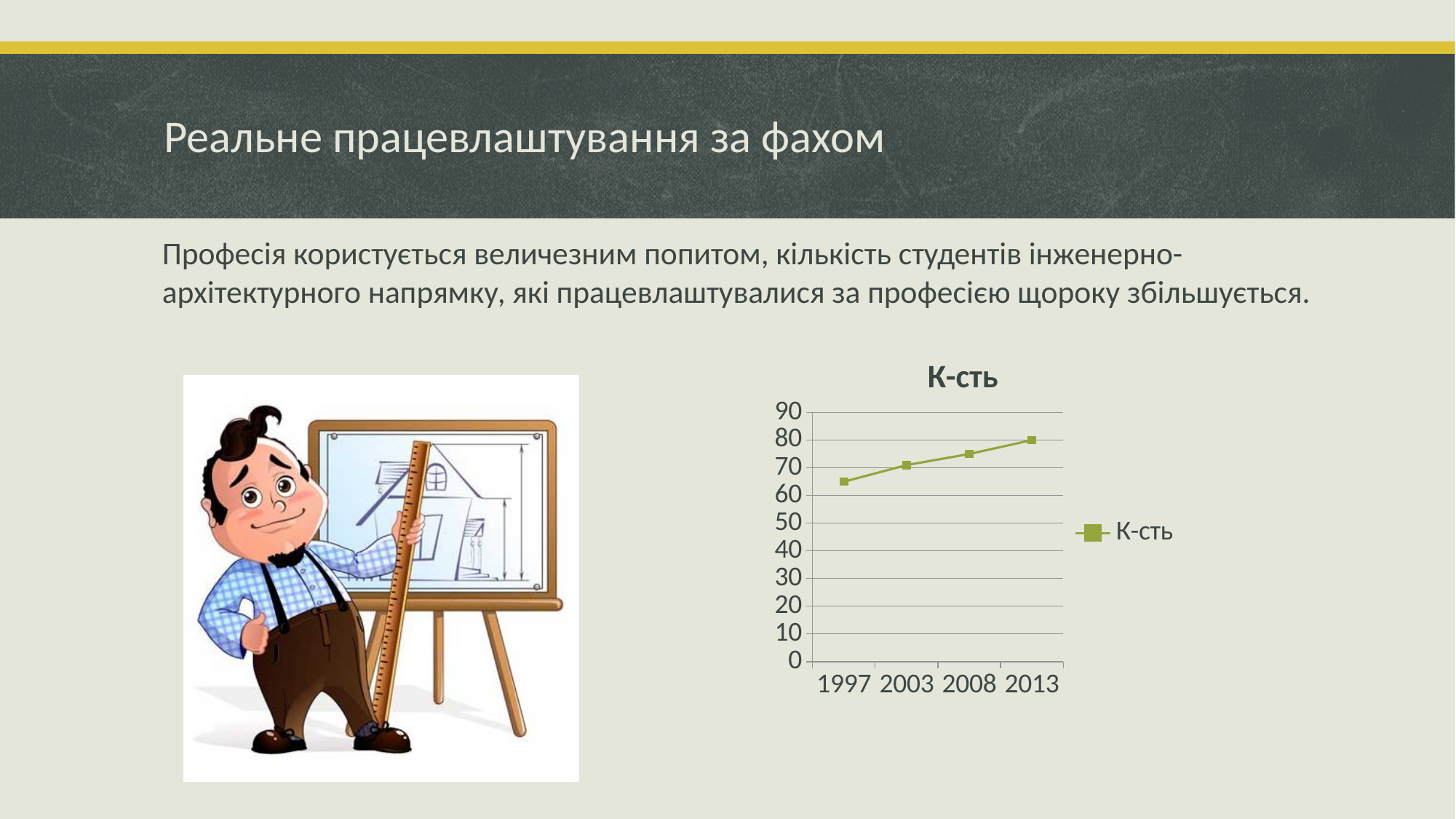
Is the value for 1997 greater or less than 70? less Is the value for 2008 greater or less than 80? less What kind of chart is shown on the slide? line chart What is the title of the chart? К-сть Which year has the highest value? 2013 Is the value for 2013 greater or less than 70? greater How many years are plotted on the x axis of the chart? 4 How many series does the legend list? 1 Which is larger, the value for 2003 or the value for 2013? 2013 Which year has the lowest value? 1997 Do the values rise or fall from 1997 to 2013? rise